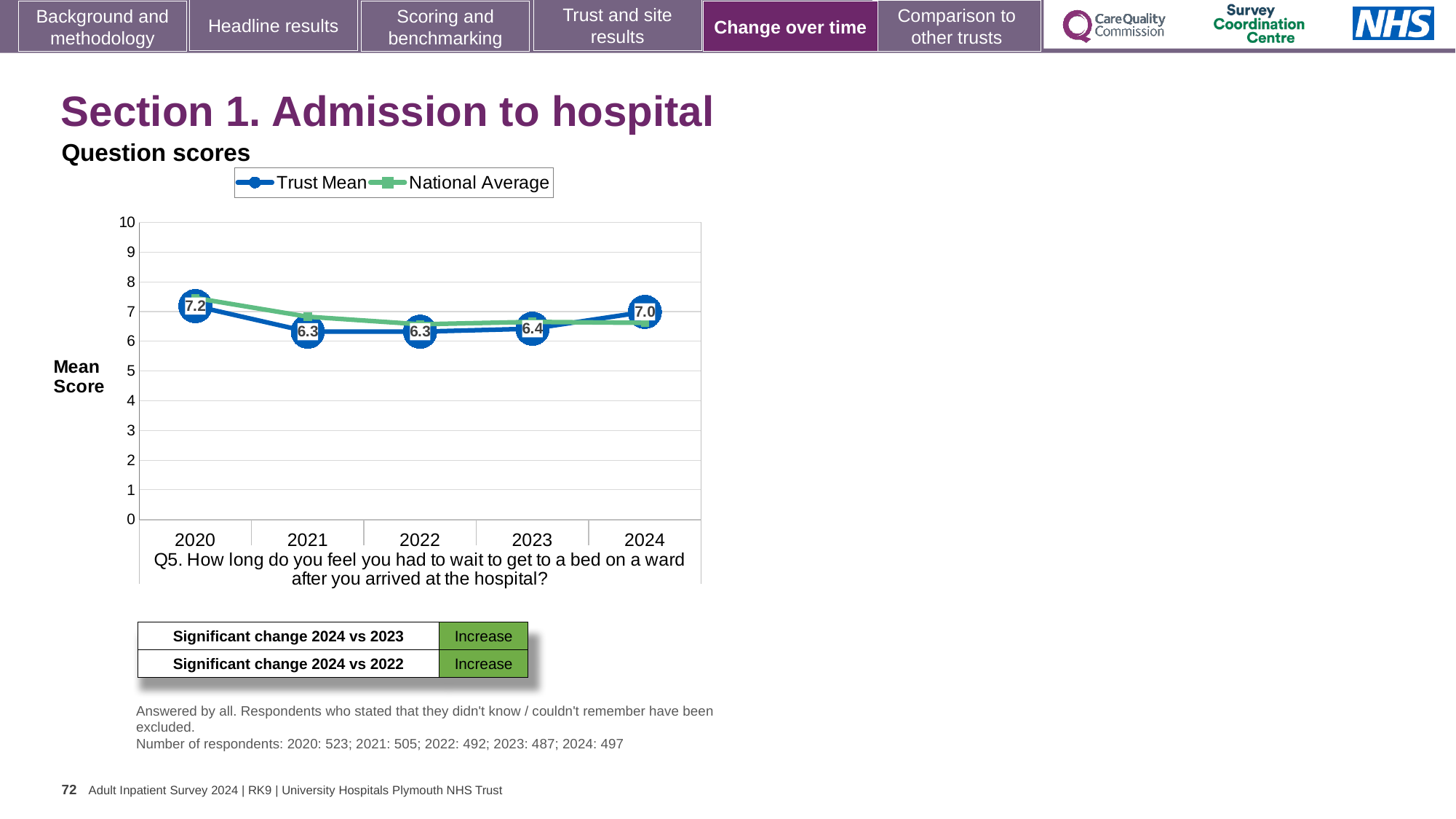
In which year is the Trust Mean score highest? 2020 Is the National Average value for 2021 greater or less than 7? less By how much did the Trust Mean score change from 2023 to 2024? 0.6 How many series does the legend list? 2 How many years are plotted on the x axis? 5 What kind of chart is shown on the slide? line chart Which year has the larger Trust Mean score, 2020 or 2024? 2020 What is the Trust Mean score for 2020? 7.2 What is the Trust Mean score for 2024? 7.0 What is the Trust Mean score for 2023? 6.4 Does the Trust Mean score rise or fall from 2023 to 2024? rise What is the difference between the Trust Mean scores for 2020 and 2021? 0.9